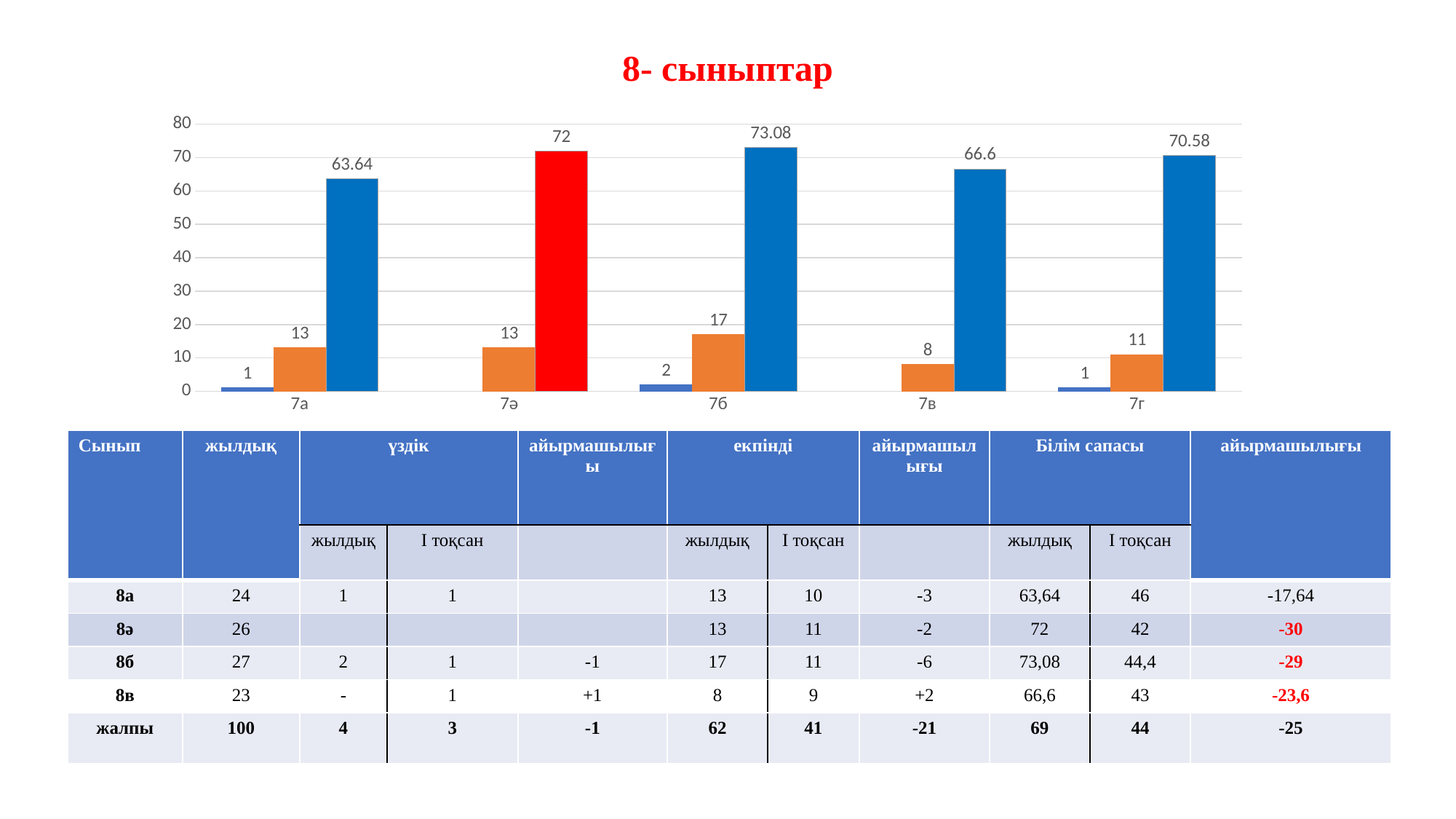
What is the value of the red bar for category 7ә? 72 How many categories are shown on the x axis of the chart? 5 What kind of chart is shown on the slide? bar chart Is the value of the tallest bar for 7в greater or less than 60? greater Which category has the lowest value among the tallest bars? 7а What is the value of the orange bar for category 7в? 8 What is the difference between the tallest bar for 7б and the tallest bar for 7а? 9.44 For which category is the tallest bar coloured red instead of blue? 7ә What is the value of the tallest bar for category 7б? 73.08 Which is larger, the orange bar for 7а or the orange bar for 7г? 7а Which category has the highest orange bar? 7б Which category has the highest value among the tallest bars? 7б